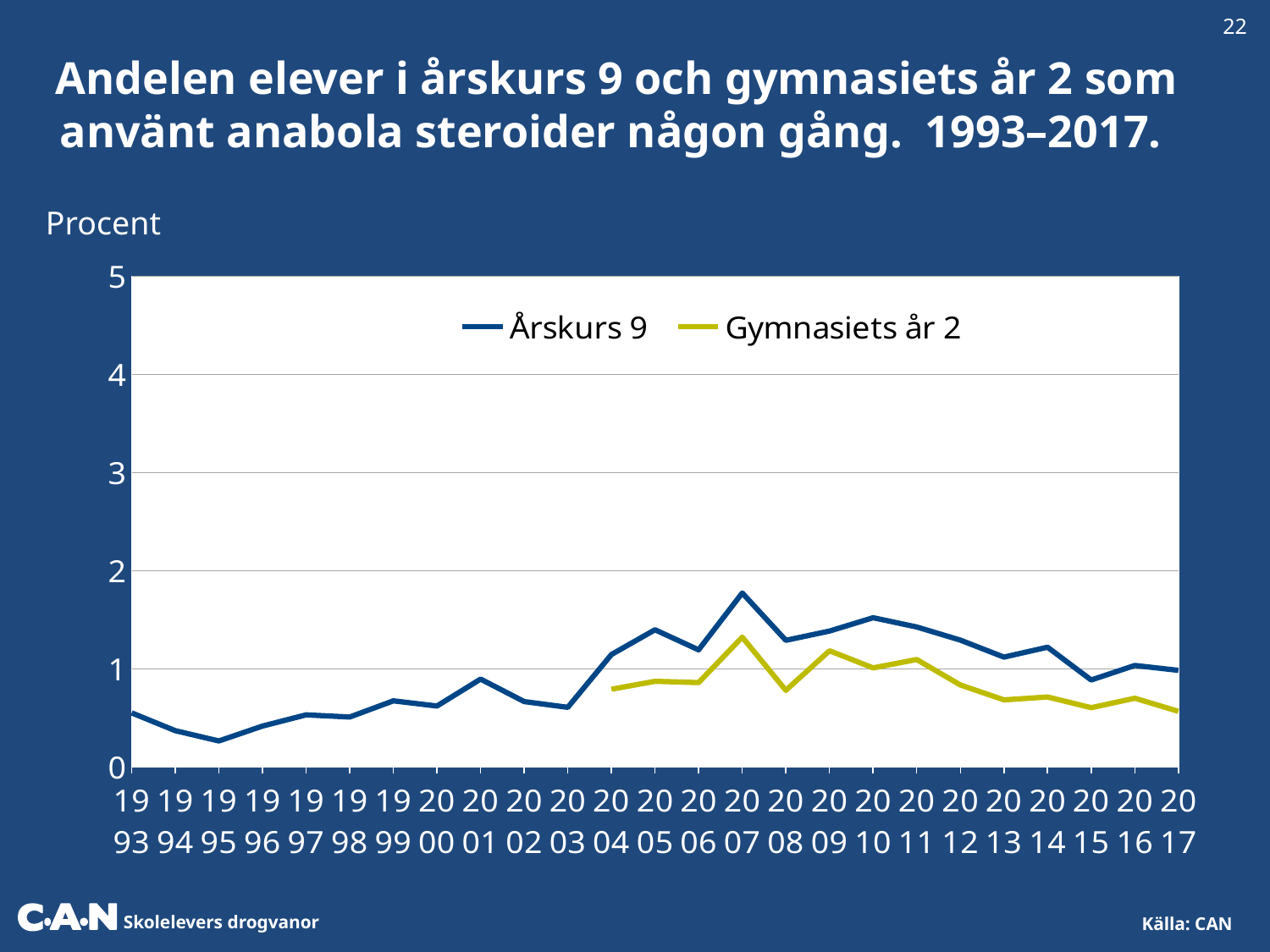
Is the value for Gymnasiets år 2 in 2017 greater or less than 1? less In which year does the Gymnasiets år 2 series reach its highest value? 2007 How many years are shown on the x axis? 25 What kind of chart is shown on the slide? line chart Is the value for Årskurs 9 in 2007 greater or less than 2? less In 2007, which series has the higher value, Årskurs 9 or Gymnasiets år 2? Årskurs 9 How many series does the legend list? 2 In which year does the Årskurs 9 series have its lowest value? 1995 In which year does the Årskurs 9 series reach its highest value? 2007 Which two series are listed in the legend? Årskurs 9 and Gymnasiets år 2 Does the Gymnasiets år 2 series rise or fall between 2011 and 2017? fall Is the value for Årskurs 9 in 2010 greater or less than 1? greater